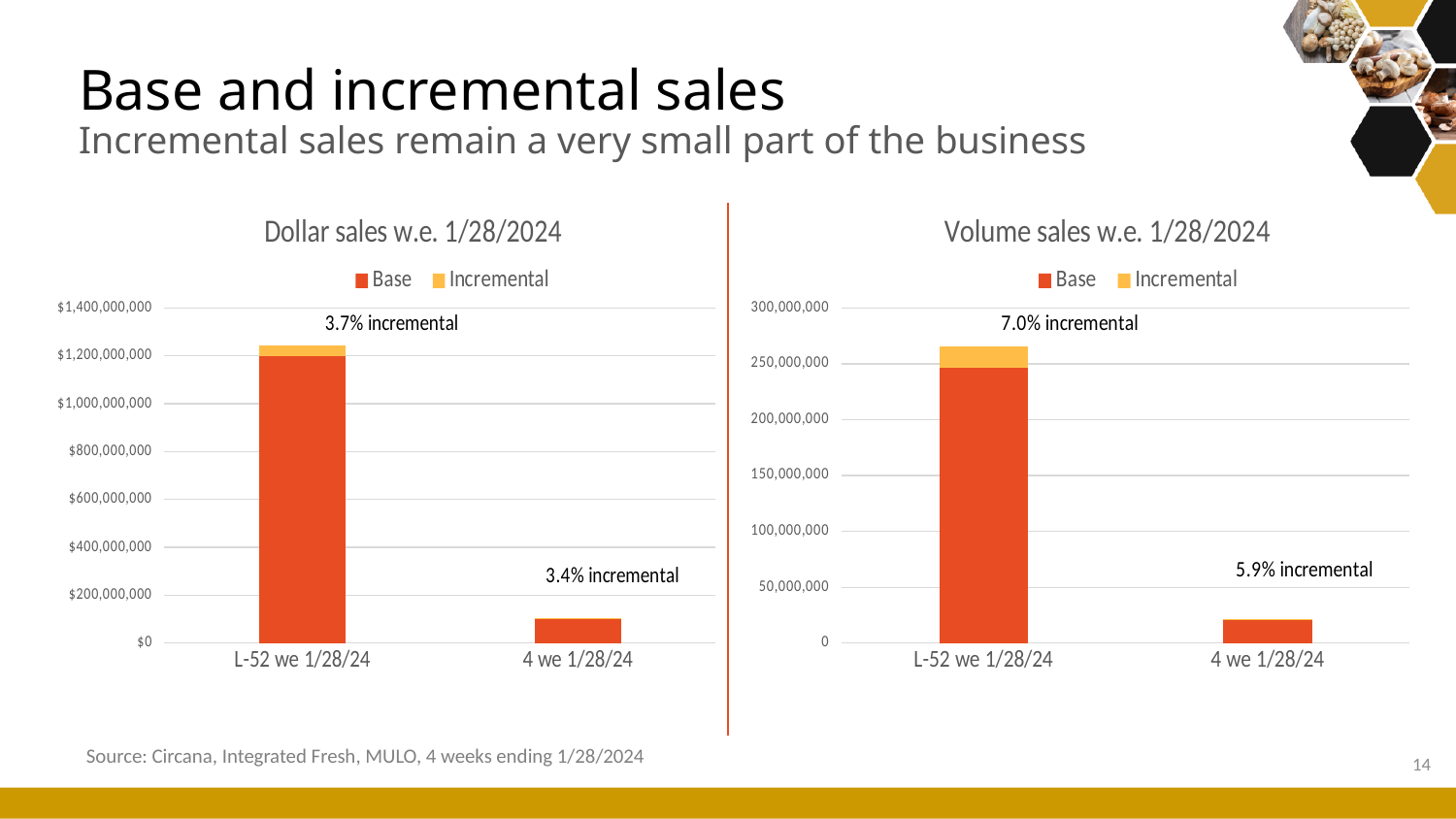
What kind of chart is the Dollar sales w.e. 1/28/2024 chart? Stacked bar chart In the Dollar sales w.e. 1/28/2024 chart, is the total bar for L-52 we 1/28/24 greater or less than $1,200,000,000? greater In the Volume sales w.e. 1/28/2024 chart, what incremental percentage is labeled for 4 we 1/28/24? 5.9% incremental In the Volume sales w.e. 1/28/2024 chart, which category has the taller bar? L-52 we 1/28/24 How many categories are shown on the x axis of the Volume sales w.e. 1/28/2024 chart? 2 In the Volume sales w.e. 1/28/2024 chart, what incremental percentage is labeled for L-52 we 1/28/24? 7.0% incremental In the Volume sales w.e. 1/28/2024 chart, is the total bar for L-52 we 1/28/24 greater or less than 250,000,000? greater In the Dollar sales w.e. 1/28/2024 chart, is the bar for 4 we 1/28/24 greater or less than $200,000,000? less How many series does the legend of the Dollar sales w.e. 1/28/2024 chart list? 2 In the Dollar sales w.e. 1/28/2024 chart, what incremental percentage is labeled for 4 we 1/28/24? 3.4% incremental In the Dollar sales w.e. 1/28/2024 chart, what incremental percentage is labeled for L-52 we 1/28/24? 3.7% incremental